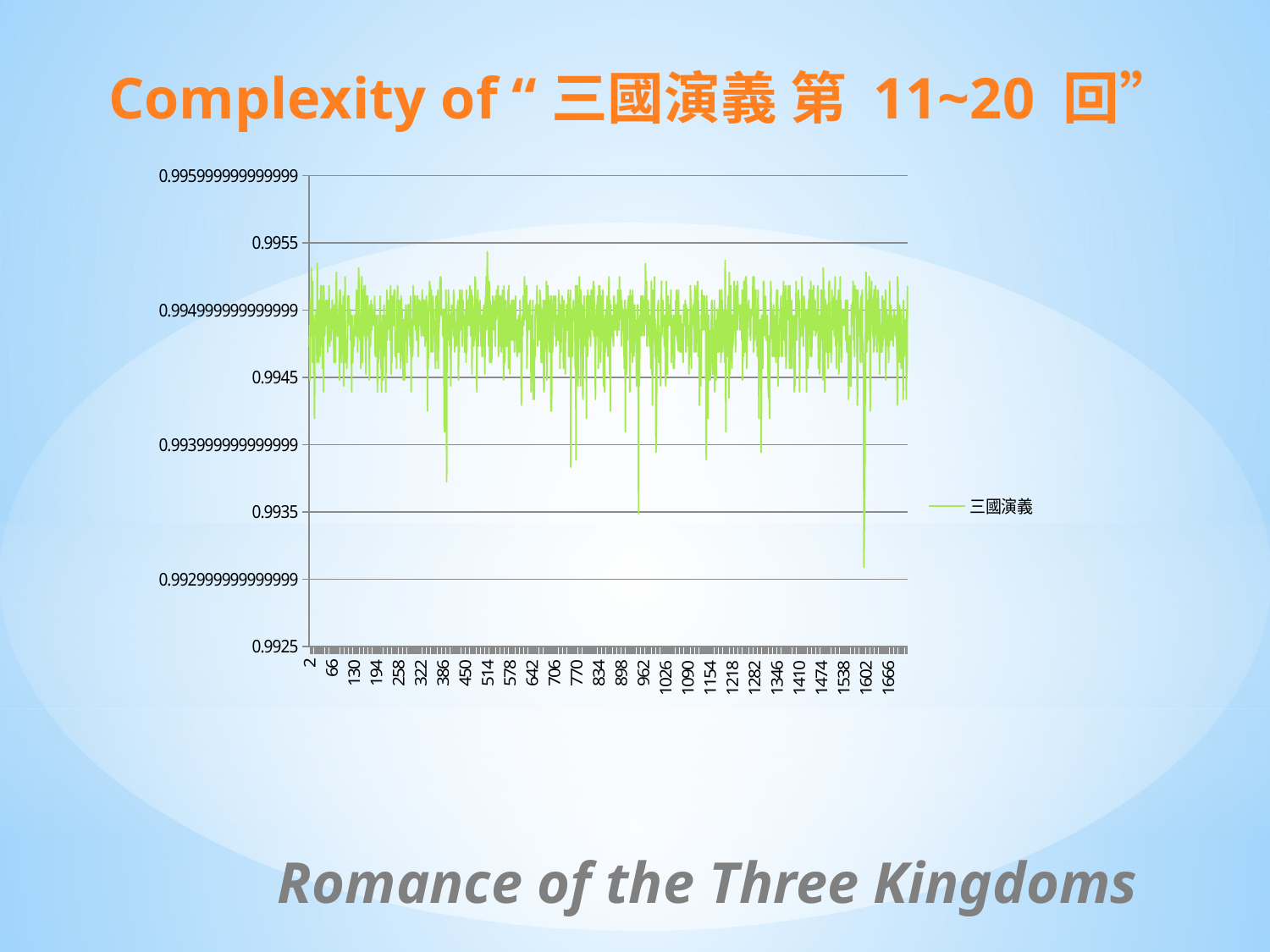
What is the first label shown on the x axis? 2 Is the lowest value plotted on the chart greater or less than 0.9925? greater What is the last label shown on the x axis? 1666 What is the lowest value shown on the y axis? 0.9925 What kind of chart is shown on the slide? line chart Is the lowest value plotted on the chart greater or less than 0.9935? less Is the highest value plotted on the chart greater or less than 0.996? less How many series does the legend list? 1 Do the values show a clear rising or falling trend along the x axis, or do they fluctuate around a roughly constant level? fluctuate around a roughly constant level